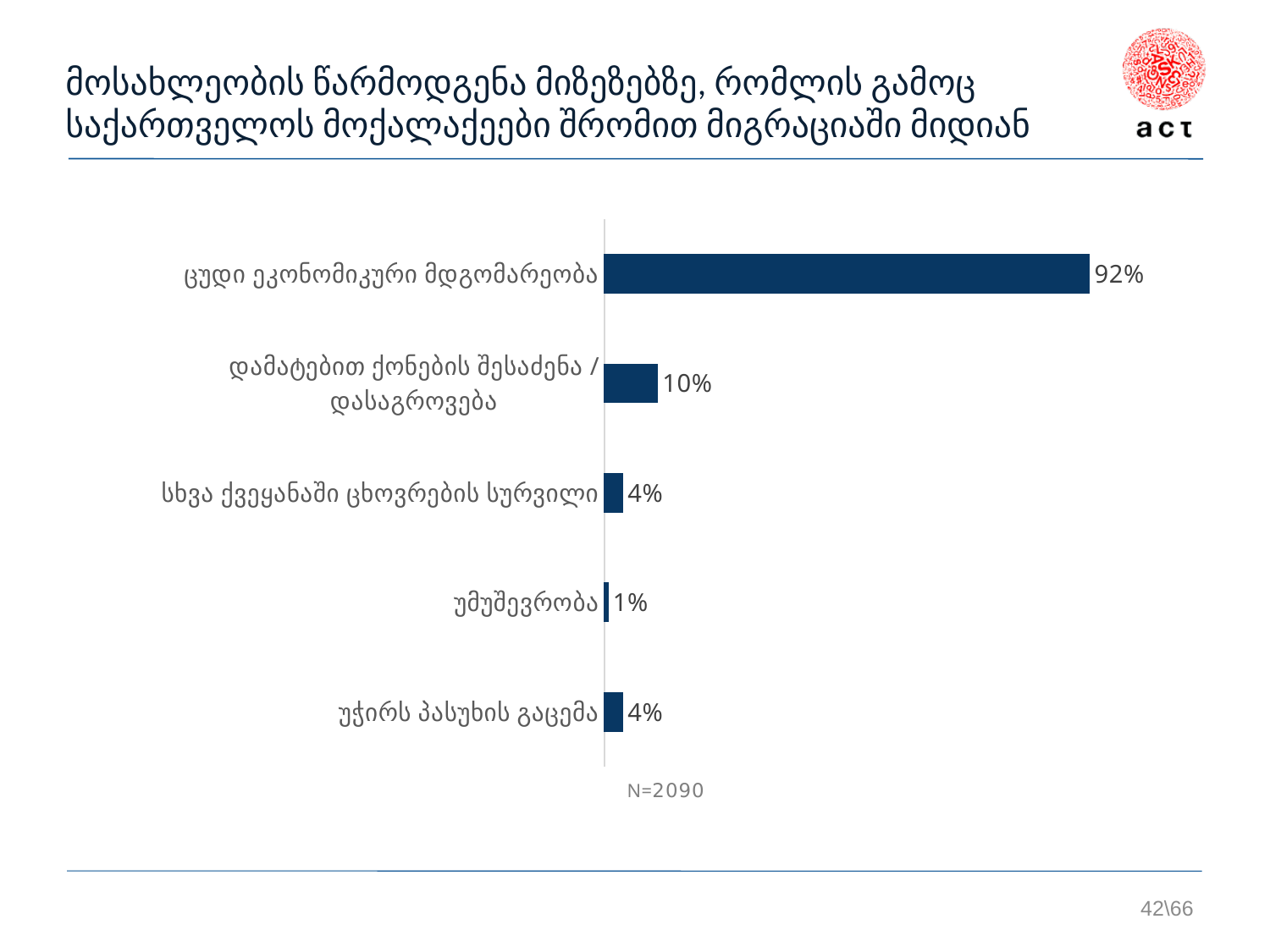
Which is larger: the value for დამატებით ქონების შესაძენა / დასაგროვება or the value for უჭირს პასუხის გაცემა? დამატებით ქონების შესაძენა / დასაგროვება What kind of chart is shown on the slide? Bar chart How many categories are shown in the chart? 5 What is the difference between the values for ცუდი ეკონომიკური მდგომარეობა and დამატებით ქონების შესაძენა / დასაგროვება? 82% What is the value for სხვა ქვეყანაში ცხოვრების სურვილი? 4% Which category has the lowest value? უმუშევრობა Which category has the highest value? ცუდი ეკონომიკური მდგომარეობა What is the difference between the values for სხვა ქვეყანაში ცხოვრების სურვილი and უმუშევრობა? 3% What is the value for ცუდი ეკონომიკური მდგომარეობა? 92% What is the value for დამატებით ქონების შესაძენა / დასაგროვება? 10% What is the value for უმუშევრობა? 1% What sample size (N) is noted below the chart? N=2090